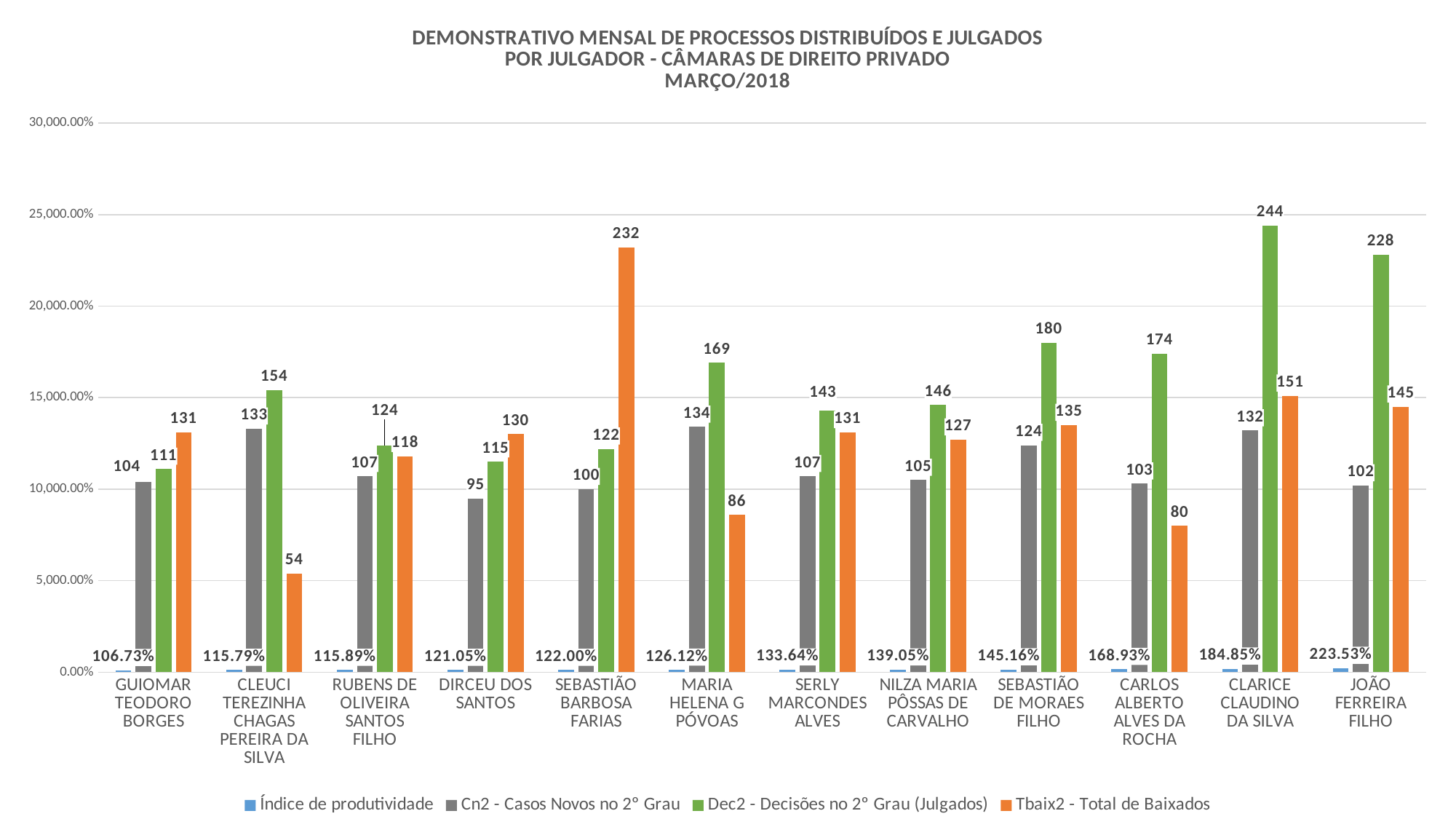
How many series does the legend list? 4 What is the Cn2 - Casos Novos no 2° Grau value for MARIA HELENA G PÓVOAS? 134 What is the Índice de produtividade for JOÃO FERREIRA FILHO? 223.53% Do the Índice de produtividade values rise or fall from left to right along the x axis? Rise What kind of chart is shown on the slide? Bar chart Which judge has the lowest Tbaix2 - Total de Baixados value? CLEUCI TEREZINHA CHAGAS PEREIRA DA SILVA Which judge has the highest Dec2 - Decisões no 2° Grau (Julgados) value? CLARICE CLAUDINO DA SILVA Which colour represents the Dec2 - Decisões no 2° Grau (Julgados) series? Green What is the Tbaix2 - Total de Baixados value for SEBASTIÃO BARBOSA FARIAS? 232 How many judges are shown on the x axis? 12 Which is larger for DIRCEU DOS SANTOS: the Cn2 - Casos Novos no 2° Grau value or the Tbaix2 - Total de Baixados value? Tbaix2 - Total de Baixados What is the difference between the Dec2 value and the Cn2 value for CARLOS ALBERTO ALVES DA ROCHA? 71